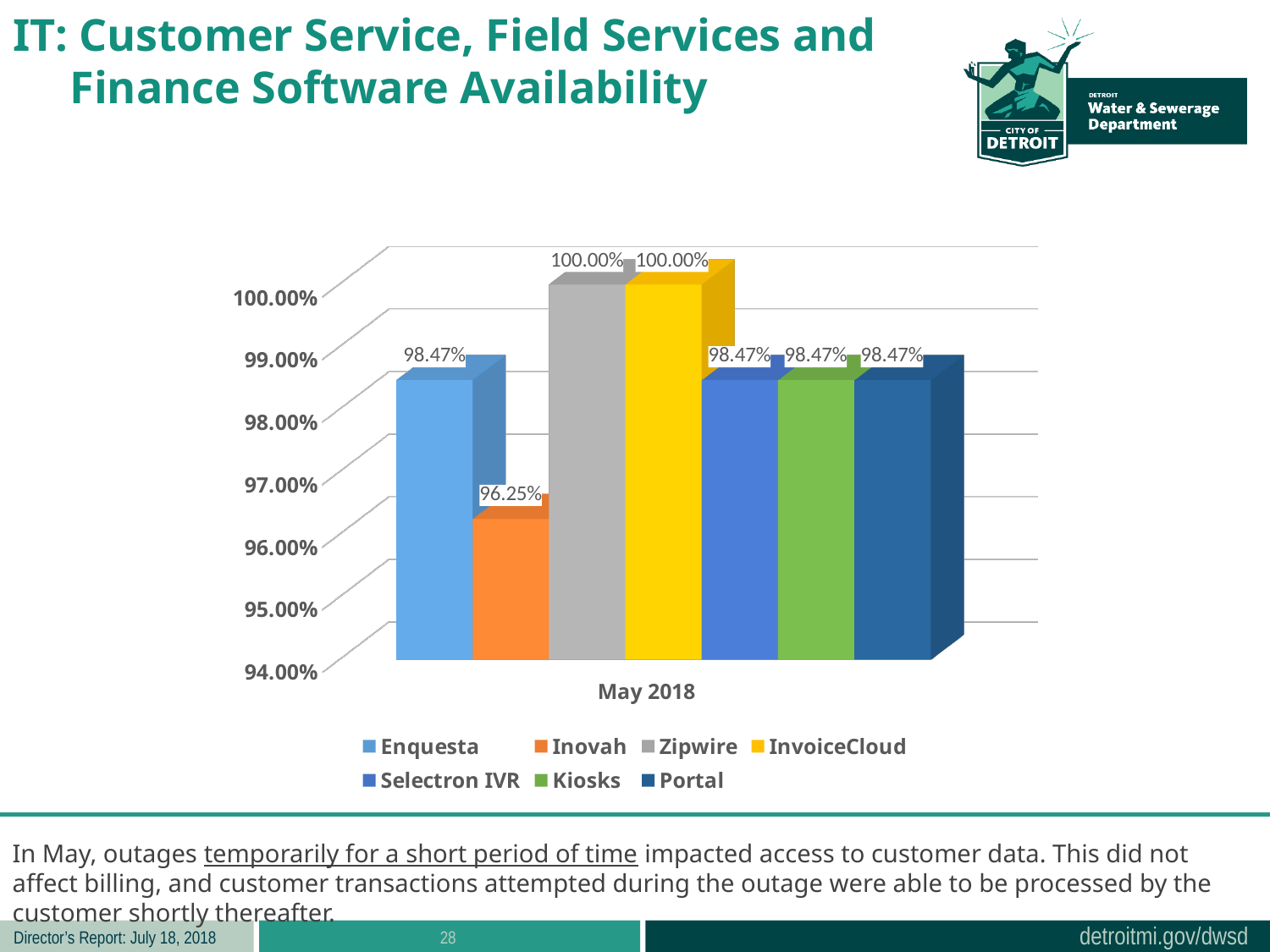
What is the difference between the InvoiceCloud value and the Inovah value? 3.75% What kind of chart is shown on the slide? bar chart What is the label on the x axis of the chart? May 2018 What is the availability value for Enquesta in May 2018? 98.47% How many series does the legend list? 7 What is the availability value for Zipwire in May 2018? 100.00% What is the availability value for Portal in May 2018? 98.47% Which series has the lowest availability value in May 2018? Inovah What is the availability value for Inovah in May 2018? 96.25% Which is larger, the value for Kiosks or the value for Inovah? Kiosks What is the difference between the Enquesta value and the Inovah value? 2.22% Is the value for Inovah greater or less than 97.00%? less